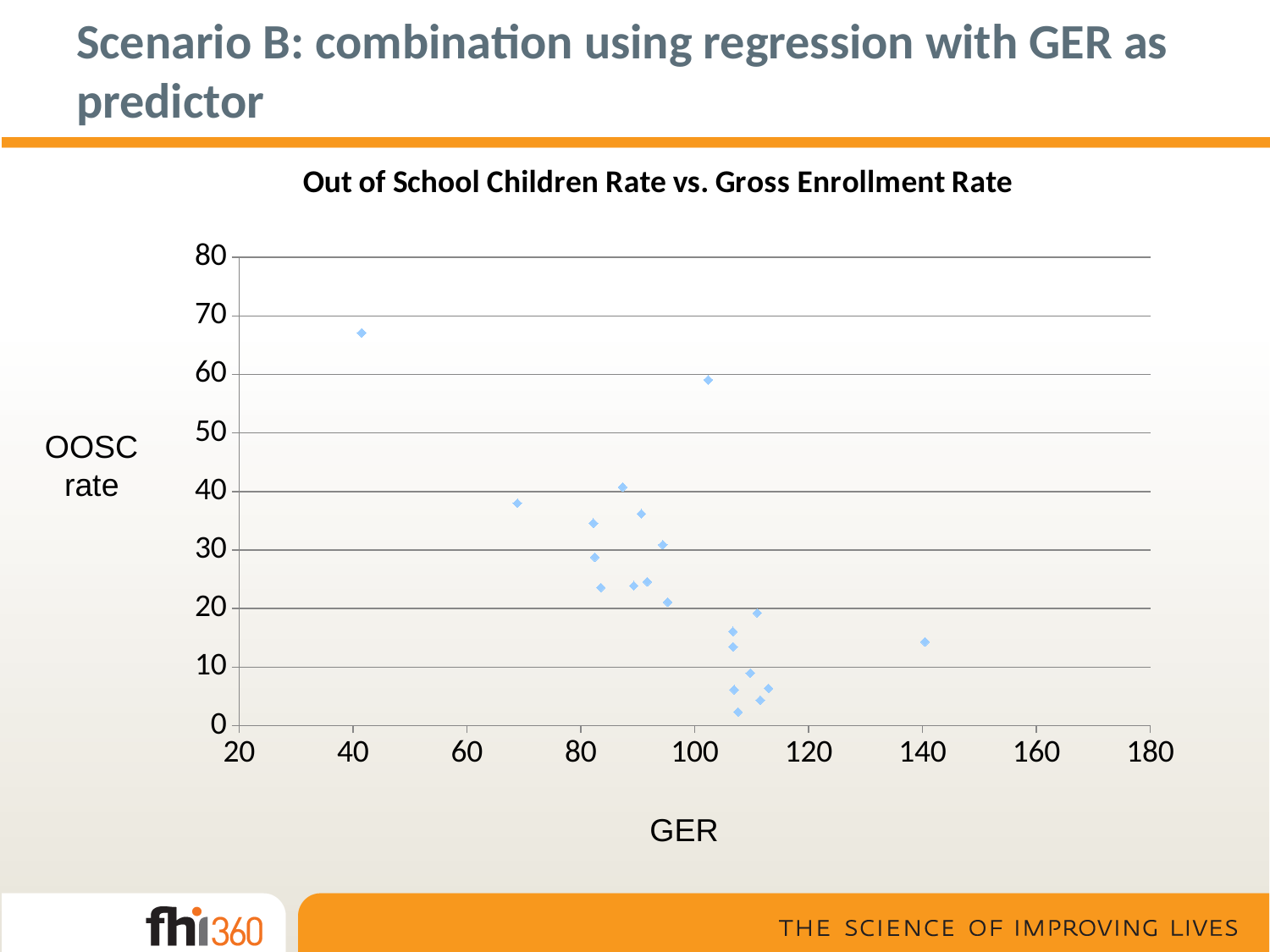
What is the title of the chart? Out of School Children Rate vs. Gross Enrollment Rate What is the label of the horizontal axis of the chart? GER Overall, do OOSC rate values rise or fall as GER increases along the x axis? Fall Is the OOSC rate for the point with the highest GER (around 140) greater or less than 20? less What kind of chart is shown on the slide? Scatter chart Which has the higher OOSC rate: the point at a GER of about 40 or the point at a GER of about 140? The point at a GER of about 40 Is the GER for the point with the highest OOSC rate greater or less than 60? less Is the OOSC rate for the point at a GER of about 102 greater or less than 50? greater What is the highest value shown on the horizontal (GER) axis? 180 What is the highest value shown on the vertical (OOSC rate) axis? 80